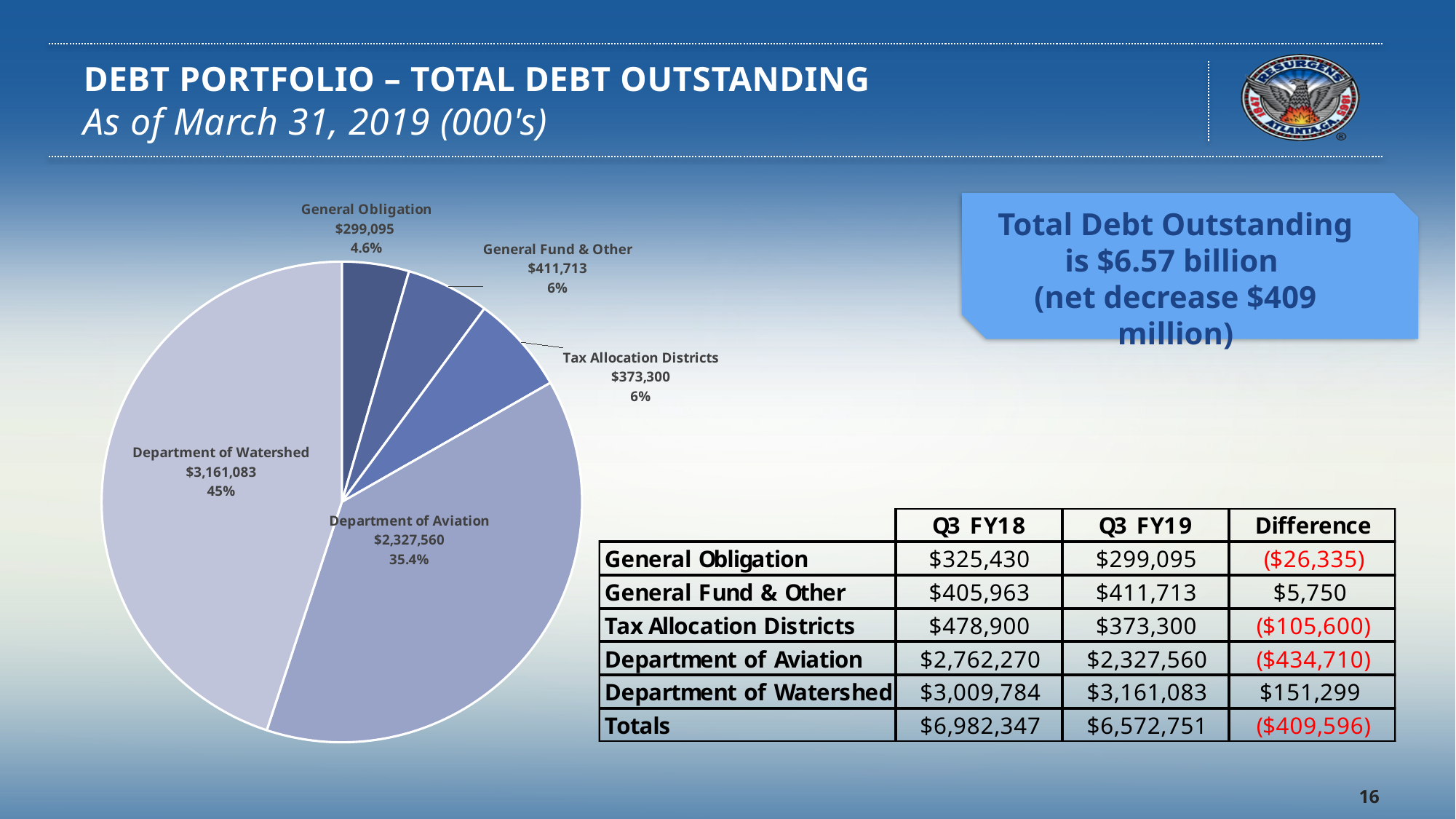
Which category has the largest slice in the pie chart? Department of Watershed What is the difference between the General Fund & Other and Tax Allocation Districts values in the pie chart? $38,413 What is the value shown for Tax Allocation Districts in the pie chart? $373,300 What kind of chart is shown on the slide? Pie chart What percentage share does the pie chart show for Department of Aviation? 35.4% What percentage share does the pie chart show for General Obligation? 4.6% What is the value shown for Department of Watershed in the pie chart? $3,161,083 How many slices does the pie chart have? 5 Which category has the smallest slice in the pie chart? General Obligation What is the difference between the Department of Watershed and Department of Aviation values in the pie chart? $833,523 Which is larger in the pie chart, General Fund & Other or Tax Allocation Districts? General Fund & Other What is the value shown for General Fund & Other in the pie chart? $411,713